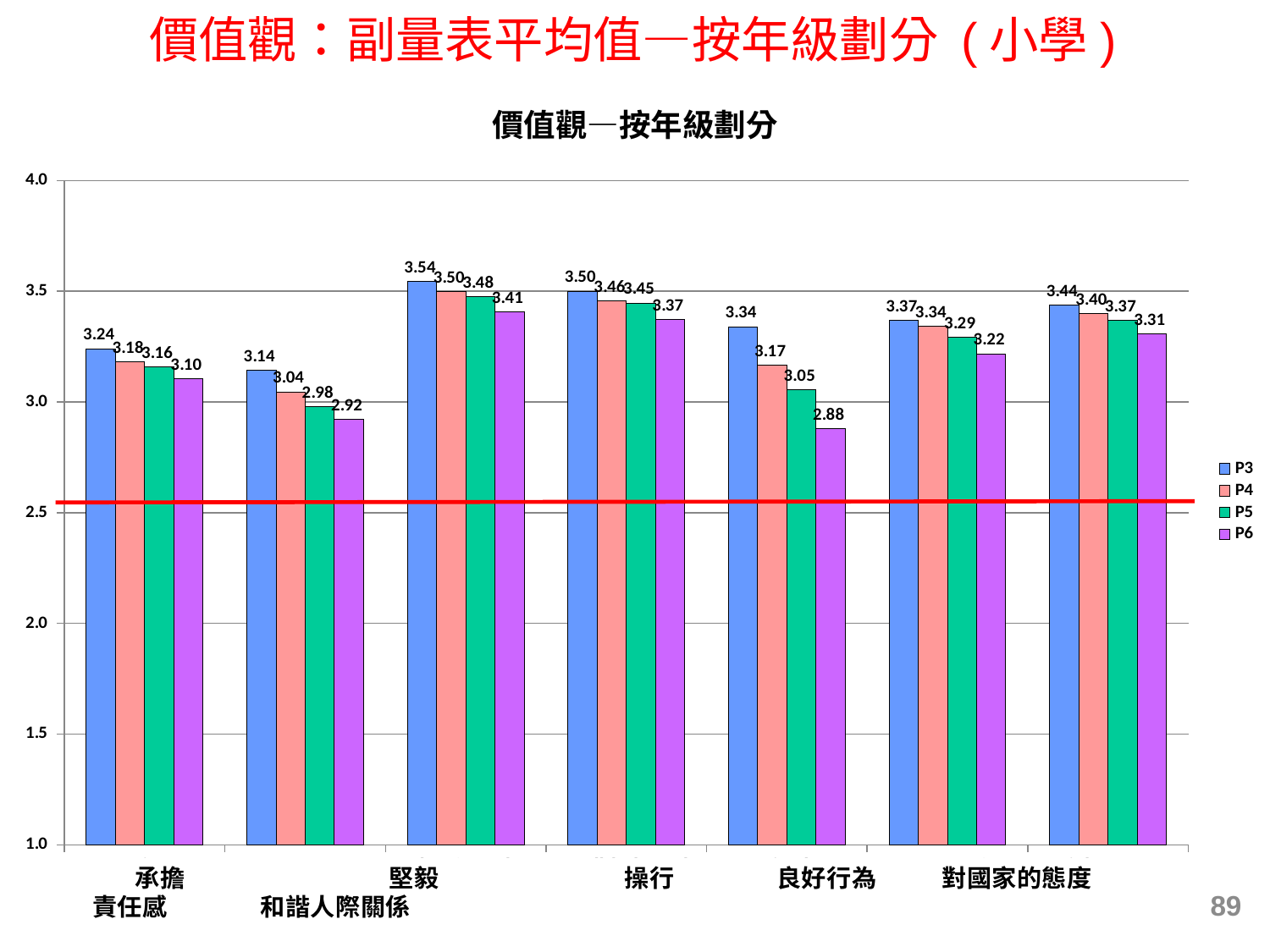
What is the P6 value for 和諧人際關係? 2.92 How many series does the legend list? 4 What is the lowest value shown in the chart? 2.88 What is the highest value shown in the chart? 3.54 For 堅毅, do the values rise or fall from P3 to P6? fall What is the difference between the P3 and P6 values for 堅毅? 0.13 Which is larger, the P3 value for 承擔責任感 or the P3 value for 和諧人際關係? 承擔責任感 What is the P3 value for 承擔責任感? 3.24 What kind of chart is shown on the slide? bar chart What is the P5 value for 承擔責任感? 3.16 What is the P3 value for 堅毅? 3.54 What is the title of the chart? 價值觀—按年級劃分